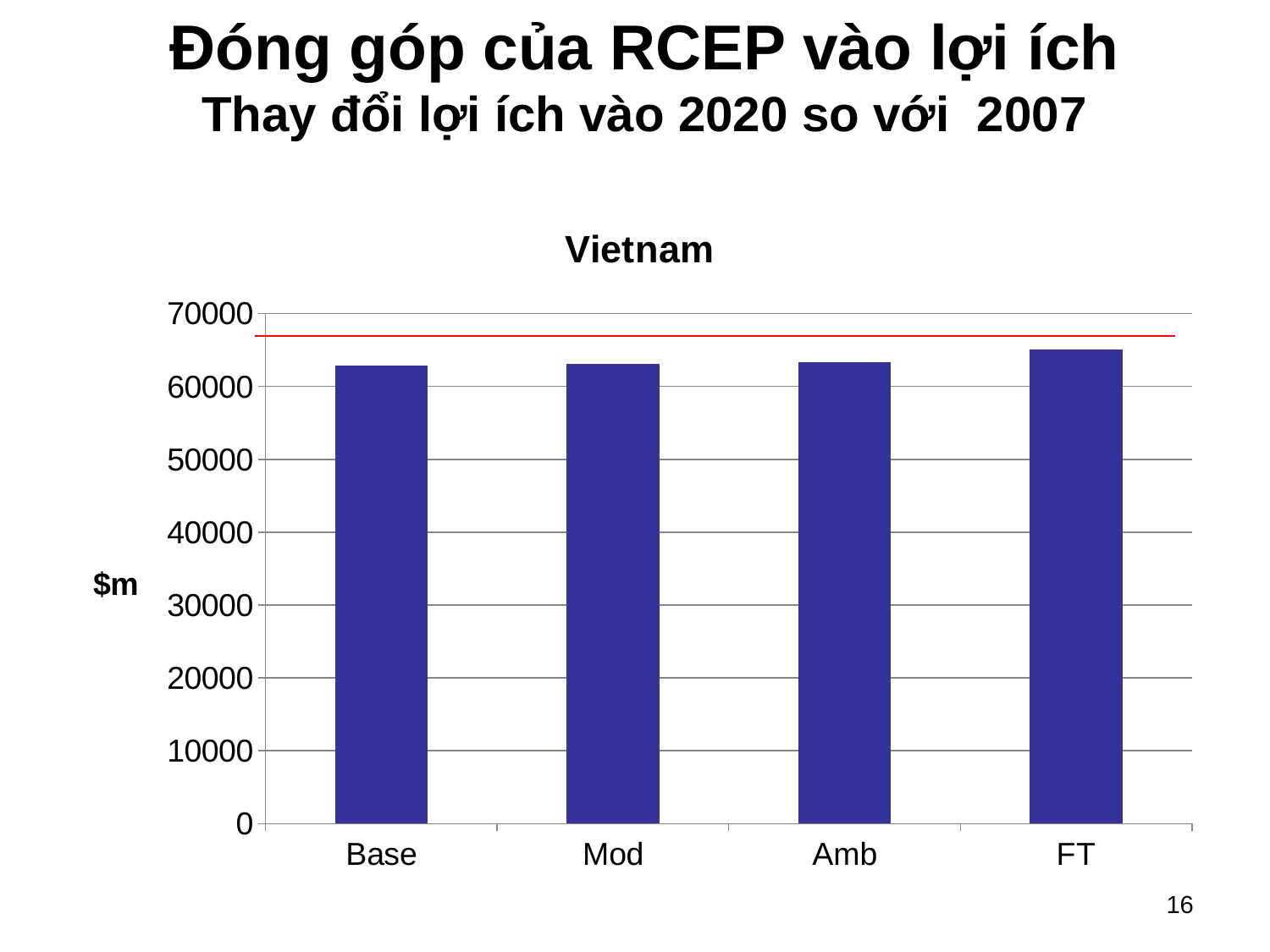
What unit label is shown on the vertical axis of the chart? $m Which is larger, the value for FT or the value for Base? FT Is the value for FT greater or less than 60000? greater Do the values rise or fall from Base to FT along the x axis? rise What is the title of the chart? Vietnam Which category has the highest value in the Vietnam chart? FT How many categories are shown on the x axis of the Vietnam chart? 4 What kind of chart is shown on the slide? bar chart Is the value for Amb greater or less than 70000? less Is the value for Mod greater or less than 50000? greater